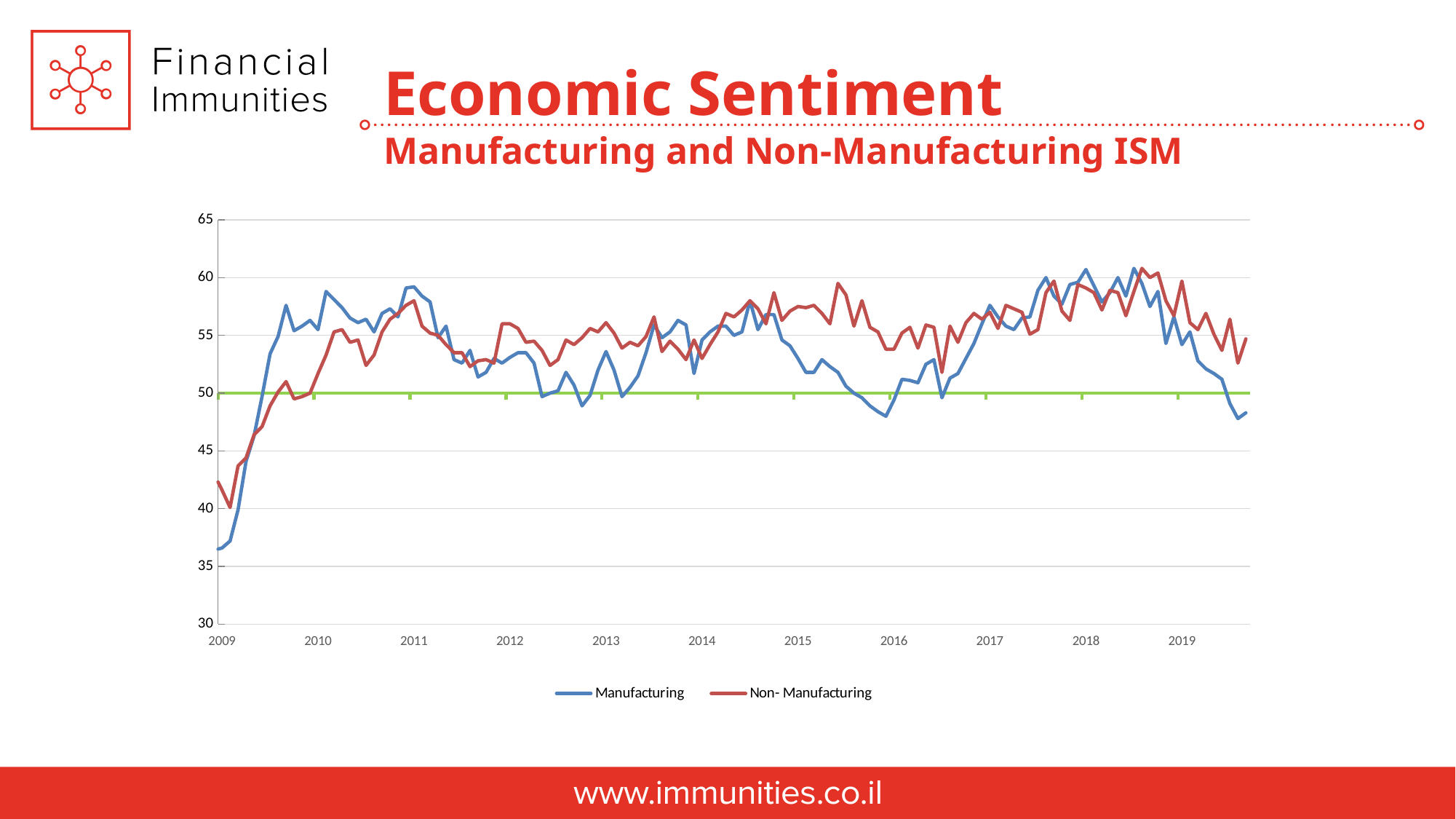
At what level is the horizontal green reference line drawn? 50 What kind of chart is shown on the slide? Line chart How many year labels are shown on the x axis? 11 Is the Non-Manufacturing value at the end of 2019 greater or less than 50? greater What are the two series named in the legend? Manufacturing and Non- Manufacturing Is the Manufacturing value at the end of 2019 greater or less than 50? less Does the Manufacturing series rise or fall between the start of 2009 and the start of 2010? Rise How many series does the legend list? 2 Is the Manufacturing value at the start of 2009 greater or less than 40? less At the start of 2009, which series has the higher value, Manufacturing or Non-Manufacturing? Non-Manufacturing At the end of 2019, which series has the higher value, Manufacturing or Non-Manufacturing? Non-Manufacturing